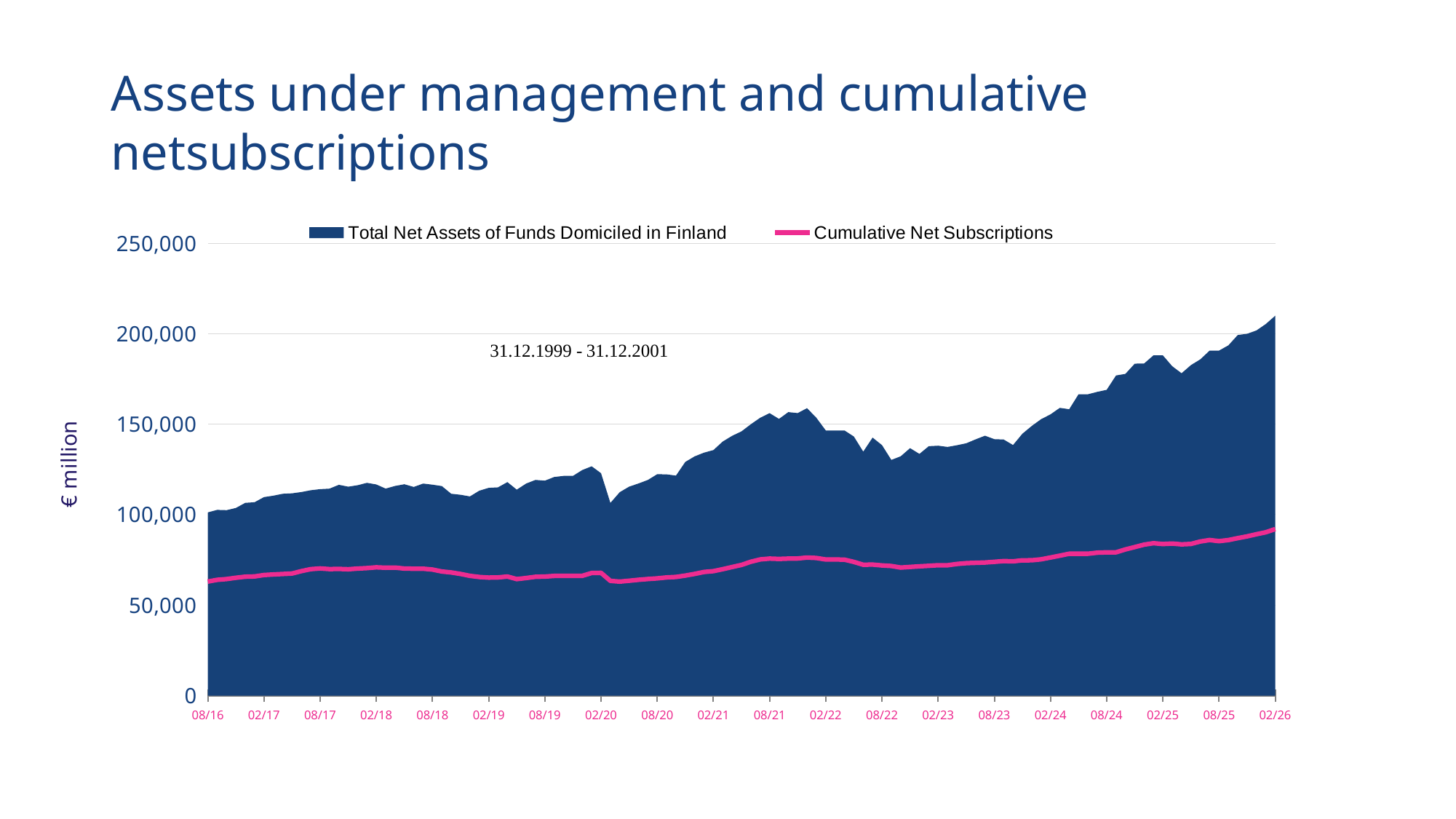
What type of chart is shown on the slide? Area chart with a line series Is the value of Total Net Assets of Funds Domiciled in Finland at 08/24 greater or less than 150,000? greater Does the Cumulative Net Subscriptions series generally rise or fall from 08/16 to 02/26? Rise Is the value of Cumulative Net Subscriptions at 02/26 greater or less than 100,000? less Is the value of Total Net Assets of Funds Domiciled in Finland at 02/26 greater or less than 200,000? greater At 02/26, which series has the larger value: Total Net Assets of Funds Domiciled in Finland or Cumulative Net Subscriptions? Total Net Assets of Funds Domiciled in Finland What unit is shown on the vertical axis label? € million What are the two series named in the legend? Total Net Assets of Funds Domiciled in Finland; Cumulative Net Subscriptions Does the Total Net Assets of Funds Domiciled in Finland series generally rise or fall from 08/16 to 02/26? Rise How many date labels are shown on the horizontal axis? 20 How many series does the legend list? 2